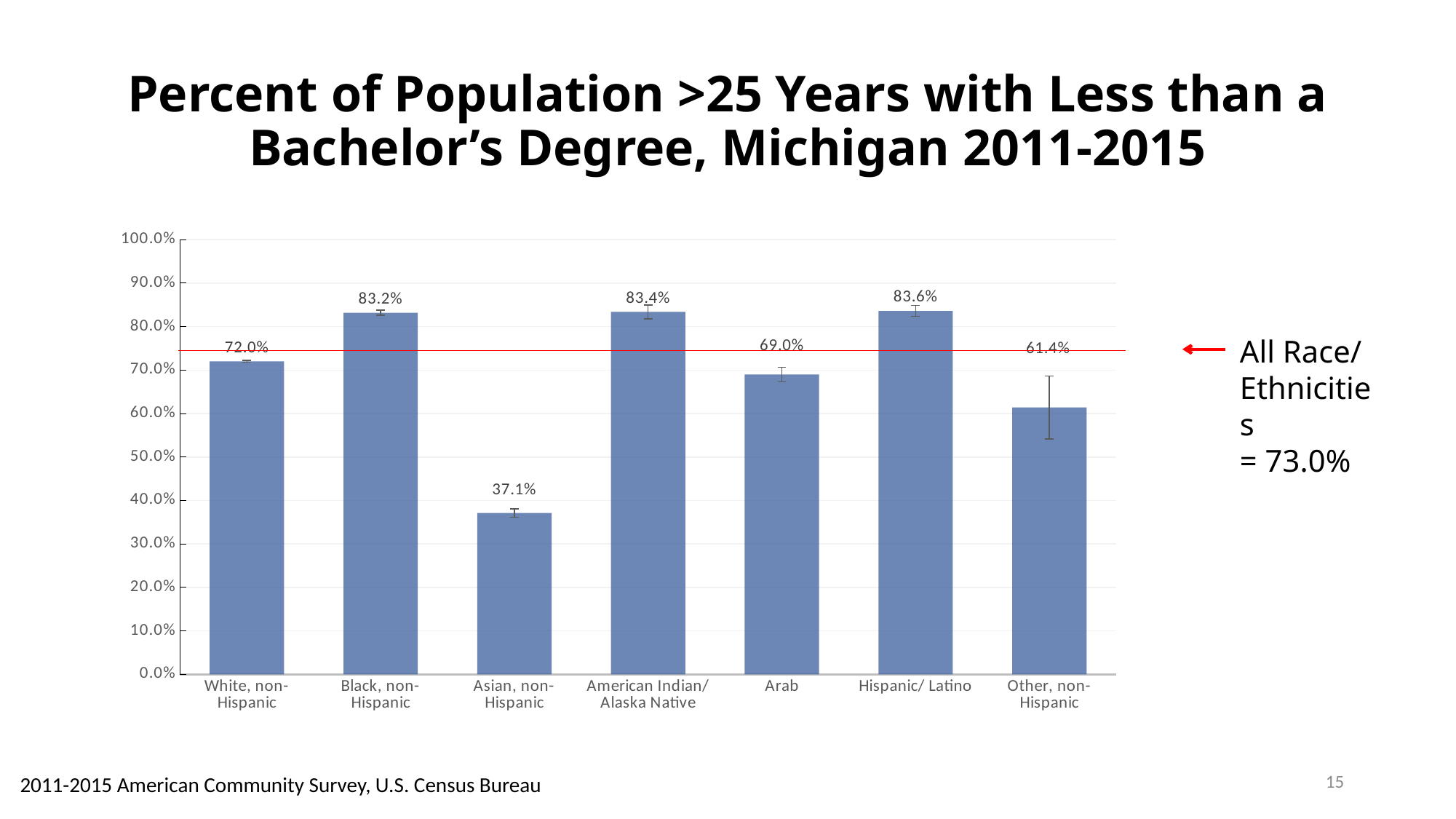
What is the difference between the values for Black, non-Hispanic and White, non-Hispanic? 11.2 percentage points What kind of chart is shown on the slide? Bar chart Which category has the highest value according to the data labels? Hispanic/ Latino Is the value for Asian, non-Hispanic greater or less than 40%? less What is the value for Asian, non-Hispanic? 37.1% How many race/ethnicity categories are shown on the chart? 7 Which category has the lowest value? Asian, non-Hispanic What is the value for Other, non-Hispanic? 61.4% What value does the horizontal reference line for All Race/Ethnicities represent? 73.0% Which is larger, the value for Arab or the value for Other, non-Hispanic? Arab What is the value for White, non-Hispanic? 72.0% What is the value for Arab? 69.0%